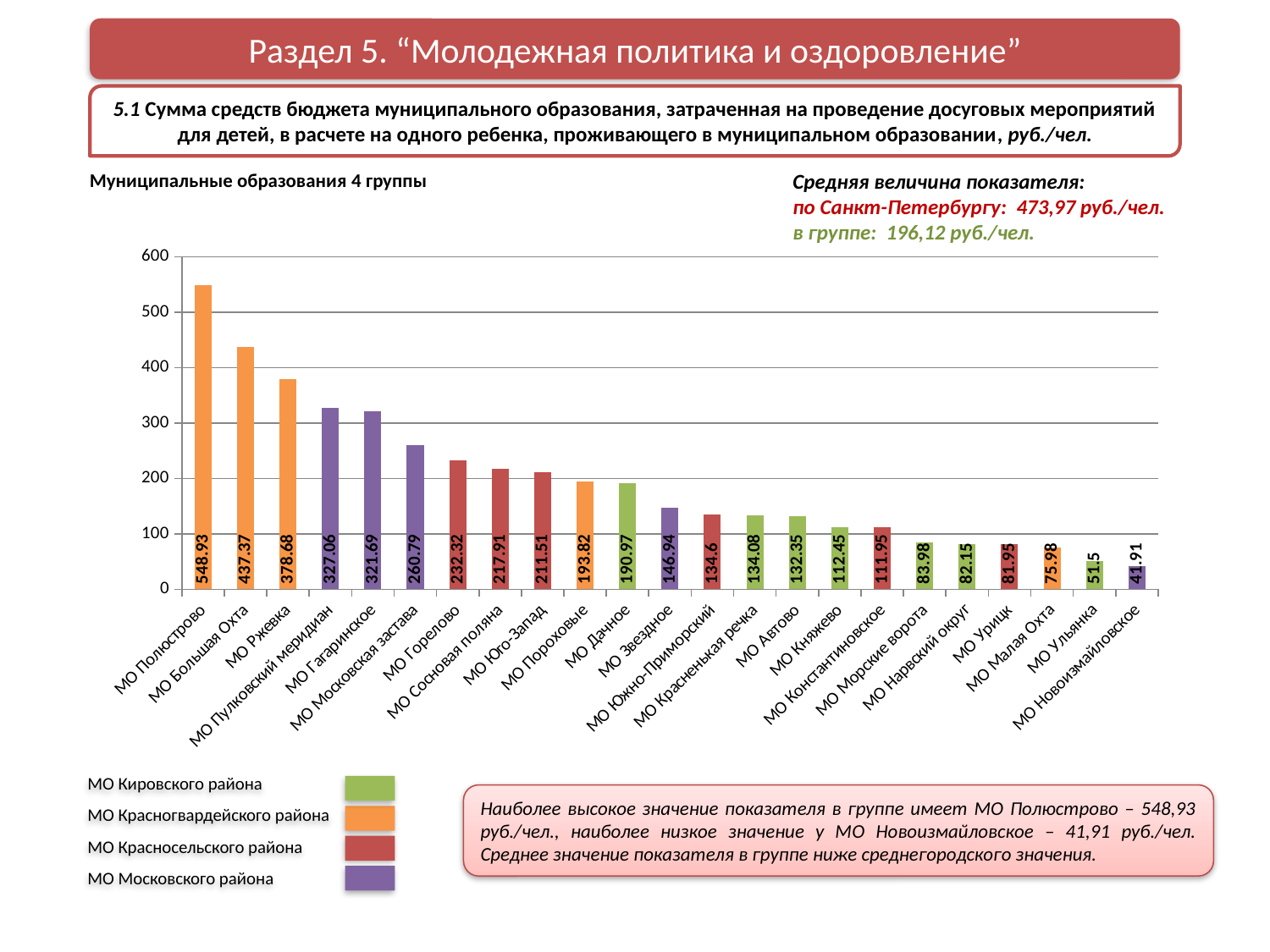
What is the value for МО Гагаринское? 321.69 Which municipality has the lowest value on the chart? МО Новоизмайловское Do the values rise or fall from left to right along the x axis? Fall Which is larger, the value for МО Горелово or the value for МО Звездное? МО Горелово What is the value for МО Ульянка? 51.5 What is the value for МО Дачное? 190.97 What is the difference between the values for МО Полюстрово and МО Большая Охта? 111.56 How many municipalities are shown on the chart? 23 What kind of chart is shown on the slide? Bar chart Which municipality has the highest value on the chart? МО Полюстрово What is the value for МО Полюстрово? 548.93 How many district groups does the legend list? 4